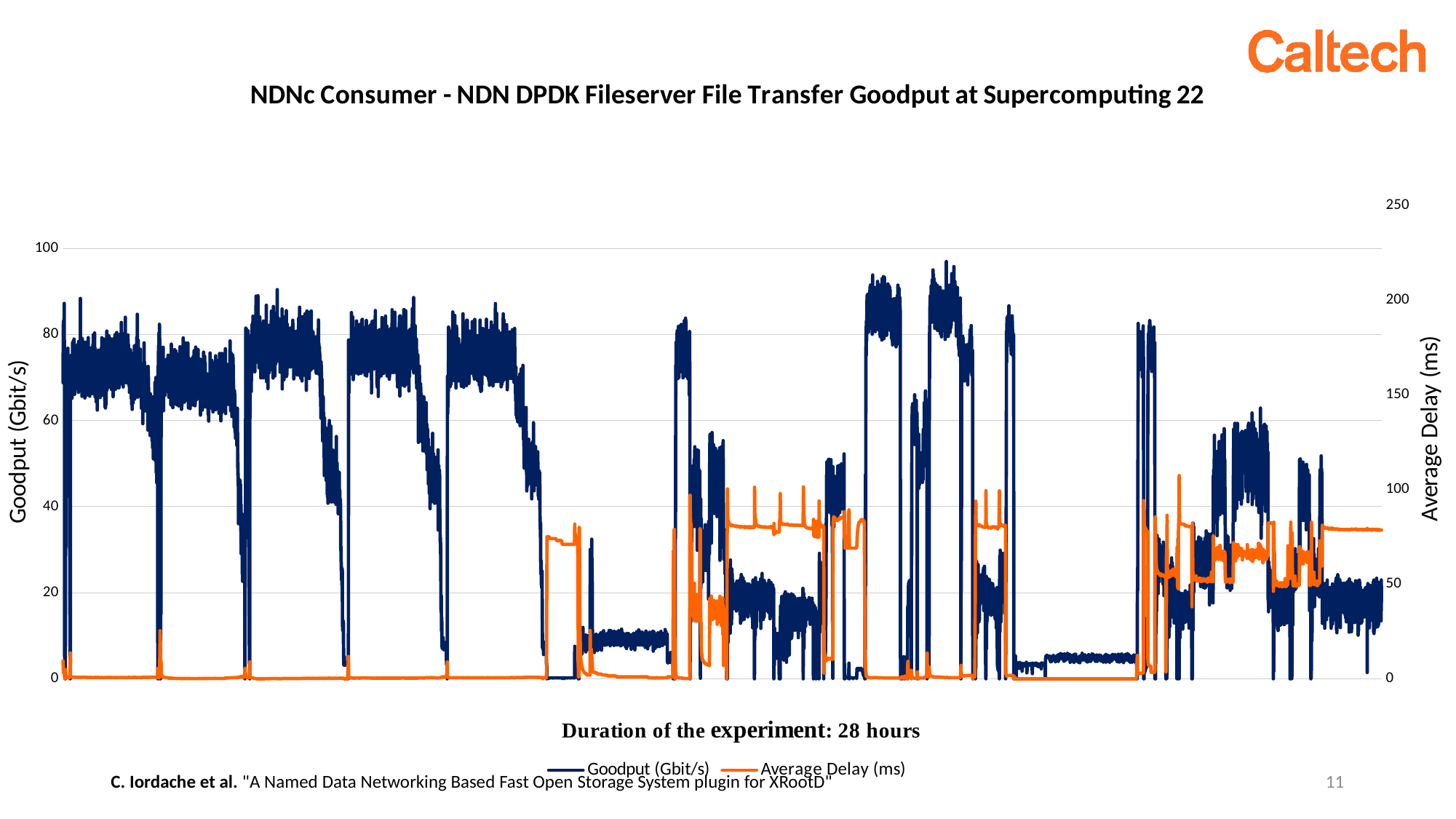
What is the title of the chart? NDNc Consumer - NDN DPDK Fileserver File Transfer Goodput at Supercomputing 22 Is the Goodput (Gbit/s) at the very end of the experiment greater or less than 40? less What kind of chart is shown on the slide? line chart What is the maximum value shown on the right vertical axis (Average Delay)? 250 Does the Average Delay (ms) series generally rise or fall over the duration of the experiment? rise Is the highest Average Delay (ms) value reached during the experiment greater or less than 150? less Is the Average Delay (ms) at the very start of the experiment greater or less than 50? less Does the Goodput (Gbit/s) series generally rise or fall over the duration of the experiment? fall How many series does the legend list? 2 Which series is drawn in orange? Average Delay (ms)